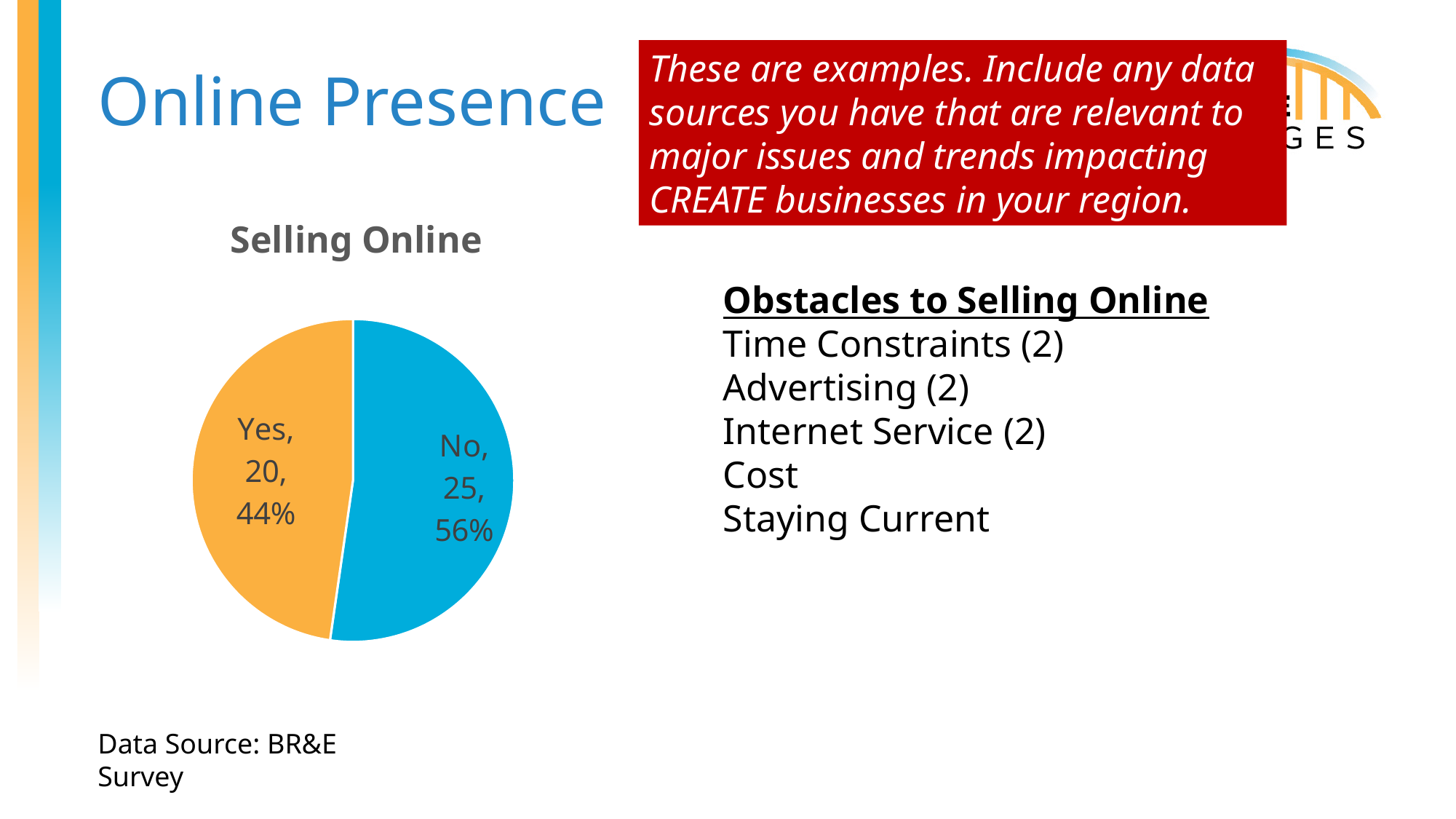
Which slice is the largest? No What kind of chart is shown on the slide? pie chart What colour is the "Yes" slice? orange Which slice is the smallest? Yes What is the title of the chart? Selling Online What is the count for the "Yes" slice? 20 What share of the pie does the "Yes" slice represent? 44% What share of the pie does the "No" slice represent? 56% Which is larger, the "Yes" slice or the "No" slice? No What is the count for the "No" slice? 25 How many slices does the pie chart have? 2 What is the difference between the "No" count and the "Yes" count? 5